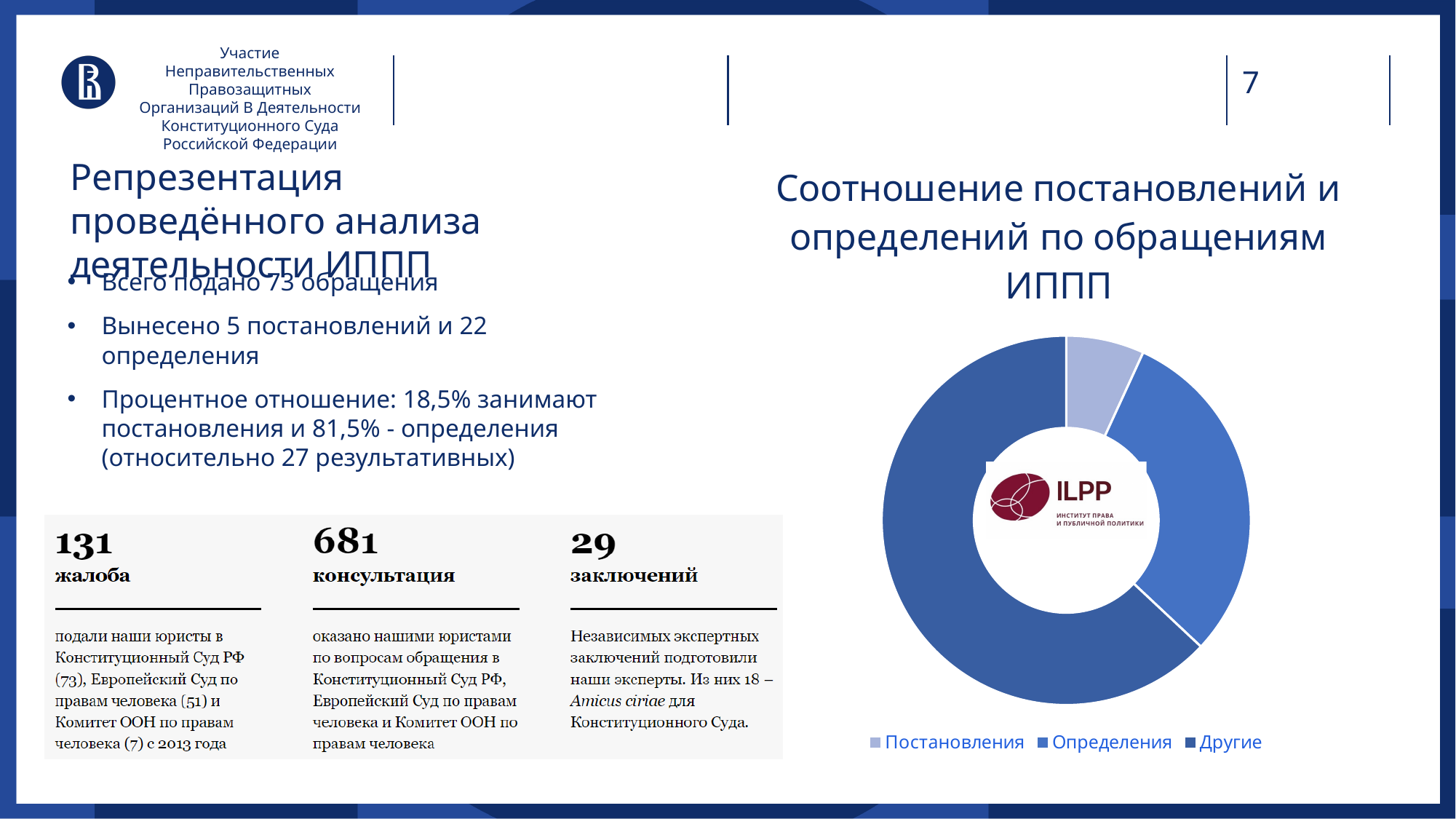
What is the title of the chart on the slide? Соотношение постановлений и определений по обращениям ИППП What kind of chart is shown on the slide? Doughnut chart Which legend entry is shown in the lightest colour in the doughnut chart? Постановления How many entries does the chart legend list? 3 Which category takes the smallest share of the doughnut chart? Постановления Which slice is larger in the doughnut chart, Определения or Постановления? Определения How many categories does the doughnut chart show? 3 Which slice is larger in the doughnut chart, Другие or Определения? Другие Which category takes the largest share of the doughnut chart? Другие